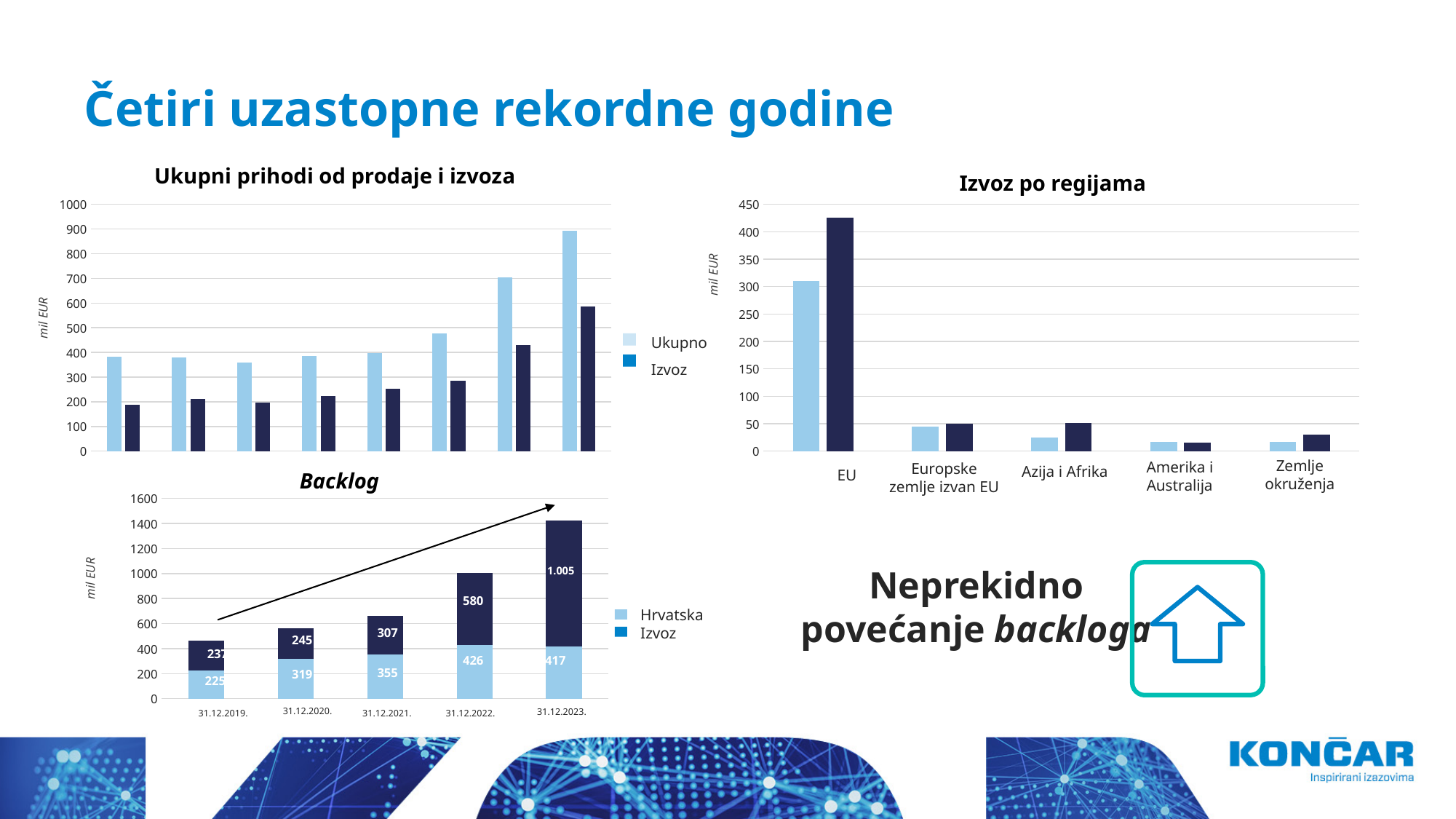
In the Izvoz po regijama chart, is the dark blue bar for EU greater or less than 400? greater In the Backlog chart, which date has the highest Izvoz value? 31.12.2023. What kind of chart is the Ukupni prihodi od prodaje i izvoza chart? Bar chart In the Backlog chart, what is the total of the stacked bar for 31.12.2019.? 462 In the Backlog chart, what is the Hrvatska value for 31.12.2021.? 355 In the Izvoz po regijama chart, how many regions are shown on the x axis? 5 In the Backlog chart, what is the Izvoz value for 31.12.2023.? 1.005 In the Backlog chart, which is larger for 31.12.2020.: Hrvatska or Izvoz? Hrvatska In the Backlog chart, what is the difference between the Izvoz values for 31.12.2022. and 31.12.2021.? 273 In the Backlog chart, which date has the lowest Hrvatska value? 31.12.2019. In the Backlog chart, how many series does the legend list? 2 In the Ukupni prihodi od prodaje i izvoza chart, is the last (rightmost) Ukupno bar greater or less than 800? greater